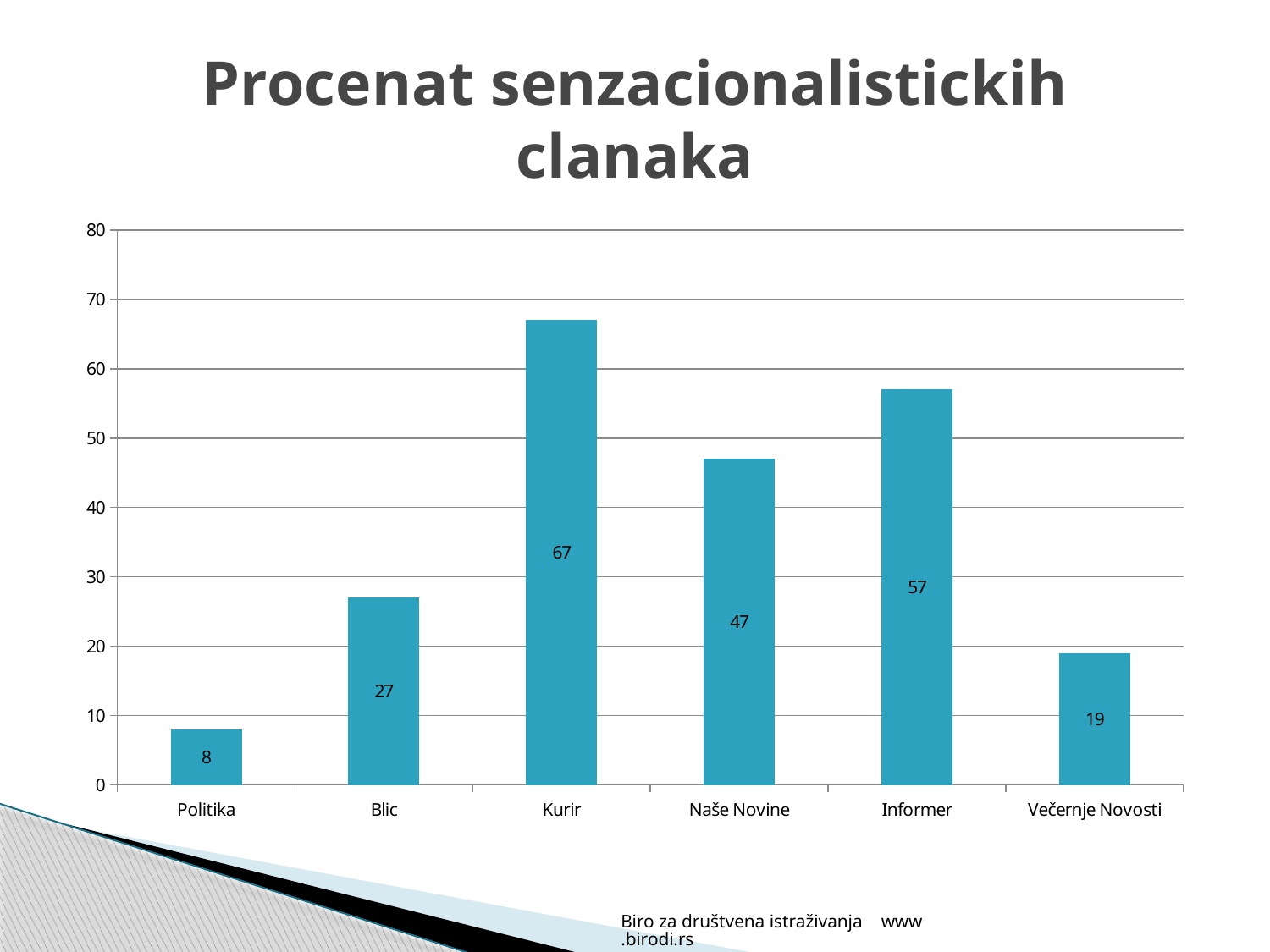
What is the value for Politika? 8 What is the value for Večernje Novosti? 19 Which category has the highest value? Kurir What kind of chart is shown on the slide? bar chart What is the value for Kurir? 67 Which is larger, the value for Naše Novine or the value for Blic? Naše Novine What is the difference between the values for Blic and Politika? 19 Which category has the lowest value? Politika What is the title of the chart on the slide? Procenat senzacionalistickih clanaka Is the value for Informer greater or less than 50? greater How many categories are shown on the x axis? 6 What is the difference between the values for Kurir and Informer? 10